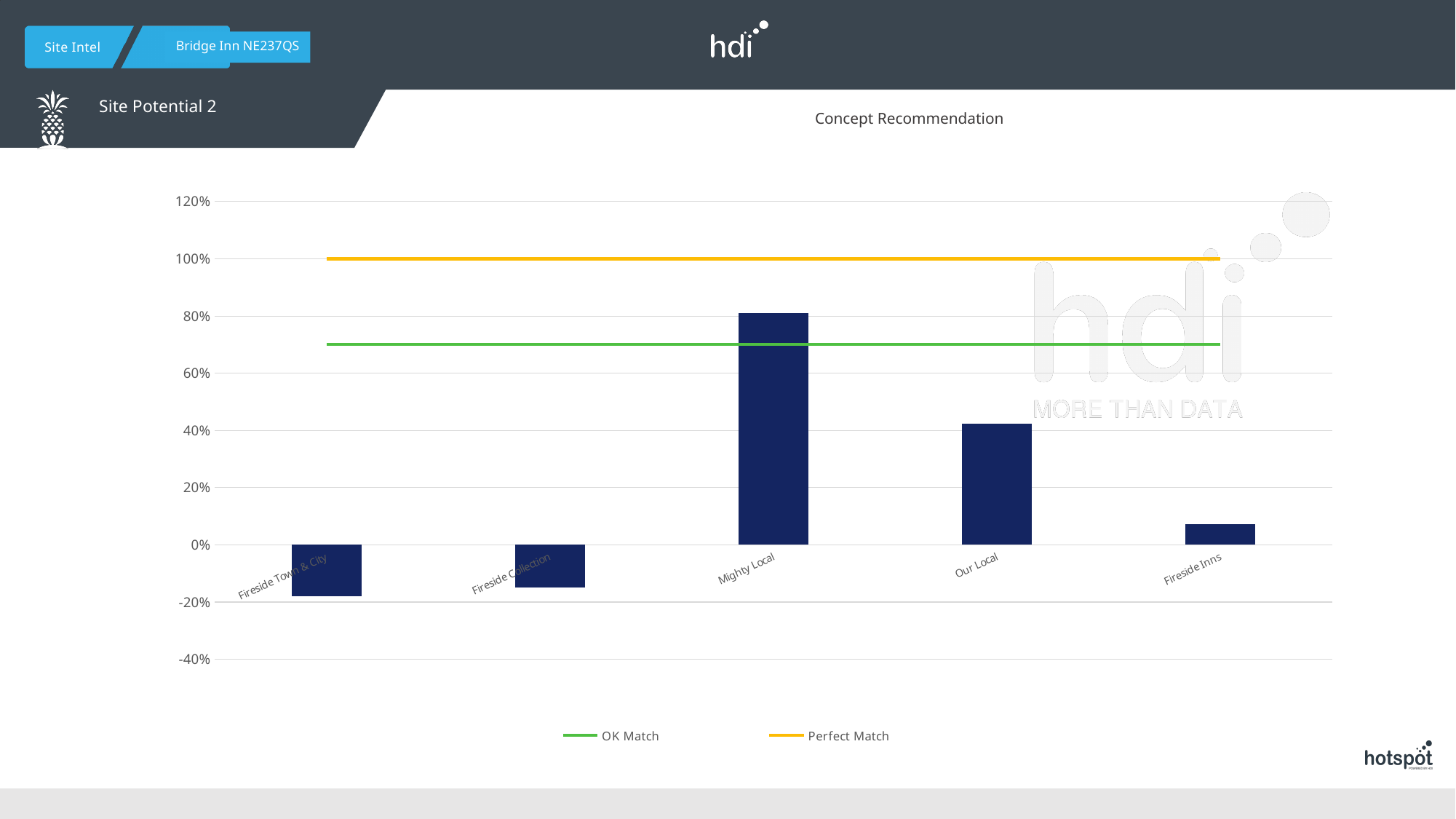
How many categories are plotted on the x axis of the chart? 5 At what level is the Perfect Match line drawn on the chart? 100% Which is larger, the value for Fireside Inns or the value for Our Local? Our Local Which is larger, the value for Mighty Local or the value for Our Local? Mighty Local Is the value for Fireside Inns greater or less than 20%? less Which category has the highest bar in the chart? Mighty Local Is the value for Fireside Town & City greater or less than 0%? less Is the value for Mighty Local greater or less than 60%? greater How many series does the chart's legend list? 2 What kind of chart is shown on the slide? combination bar and line chart What is the title of the chart? Concept Recommendation